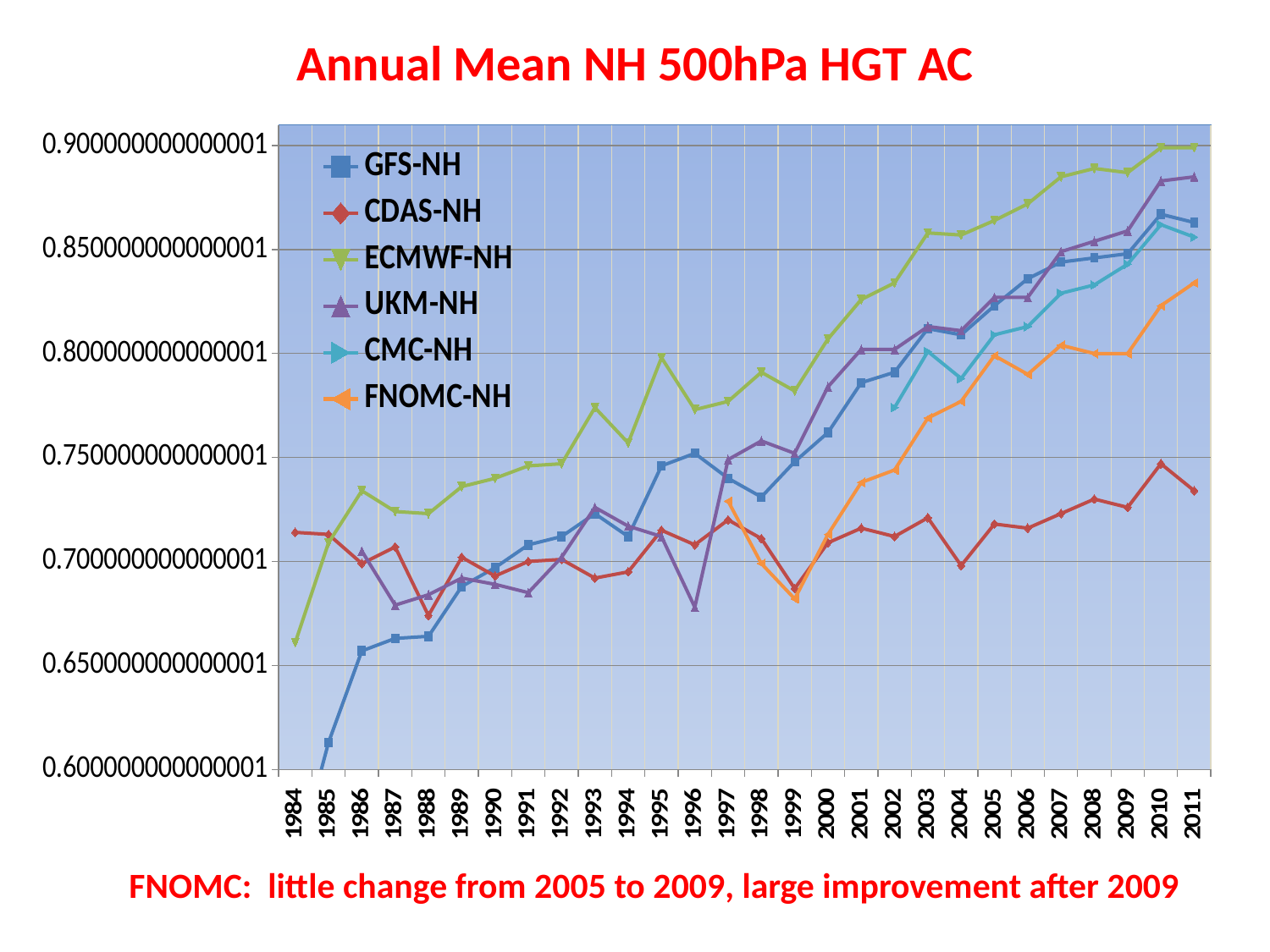
How many years are shown along the x axis? 28 In 2004, which is larger: the value for FNOMC-NH or the value for CDAS-NH? FNOMC-NH How many series does the legend list? 6 Is the value for GFS-NH in 1985 greater or less than 0.65? less What is the title of the chart? Annual Mean NH 500hPa HGT AC What kind of chart is shown on the slide? line chart Which series has the highest value in 2011? ECMWF-NH Is the value for CDAS-NH in 2011 greater or less than 0.75? less Is the value for ECMWF-NH in 2011 greater or less than 0.85? greater Which series has the lowest value in 2011? CDAS-NH Does the ECMWF-NH series generally rise or fall from 1984 to 2011? rise Which series is drawn in orange? FNOMC-NH